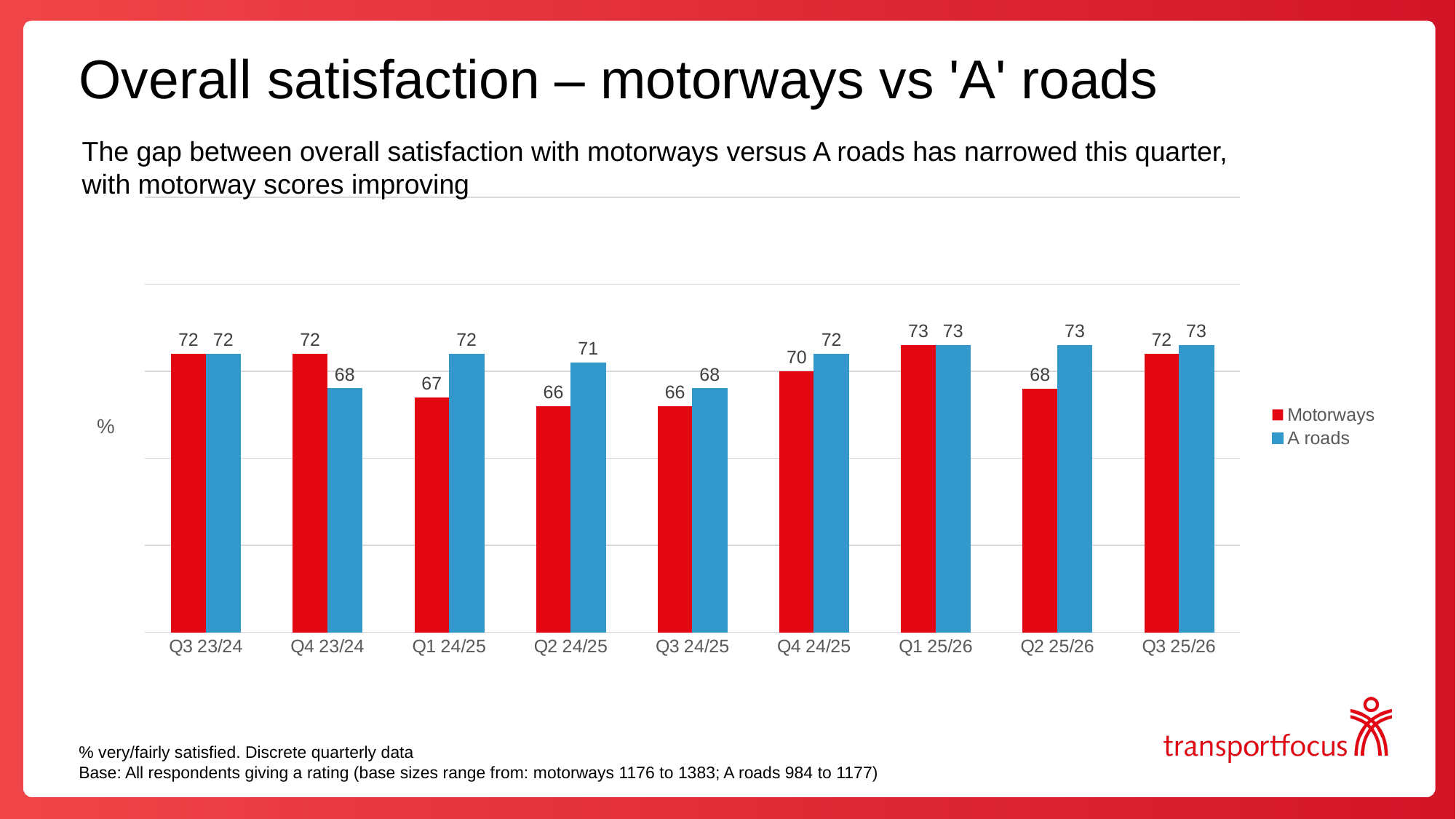
What kind of chart is shown on the slide? Bar chart What is the A roads value for Q2 24/25? 71 What is the Motorways value for Q4 24/25? 70 How many quarters are shown on the x axis? 9 Which quarter has the lowest A roads value? Q4 23/24 and Q3 24/25 (both 68) What is the Motorways value for Q3 25/26? 72 Which colour represents Motorways in the chart? Red What is the A roads value for Q4 23/24? 68 In Q1 24/25, which is larger, the Motorways value or the A roads value? A roads How many series does the legend list? 2 What is the difference between the A roads and Motorways values in Q2 25/26? 5 What is the difference between the Motorways values for Q1 25/26 and Q3 24/25? 7